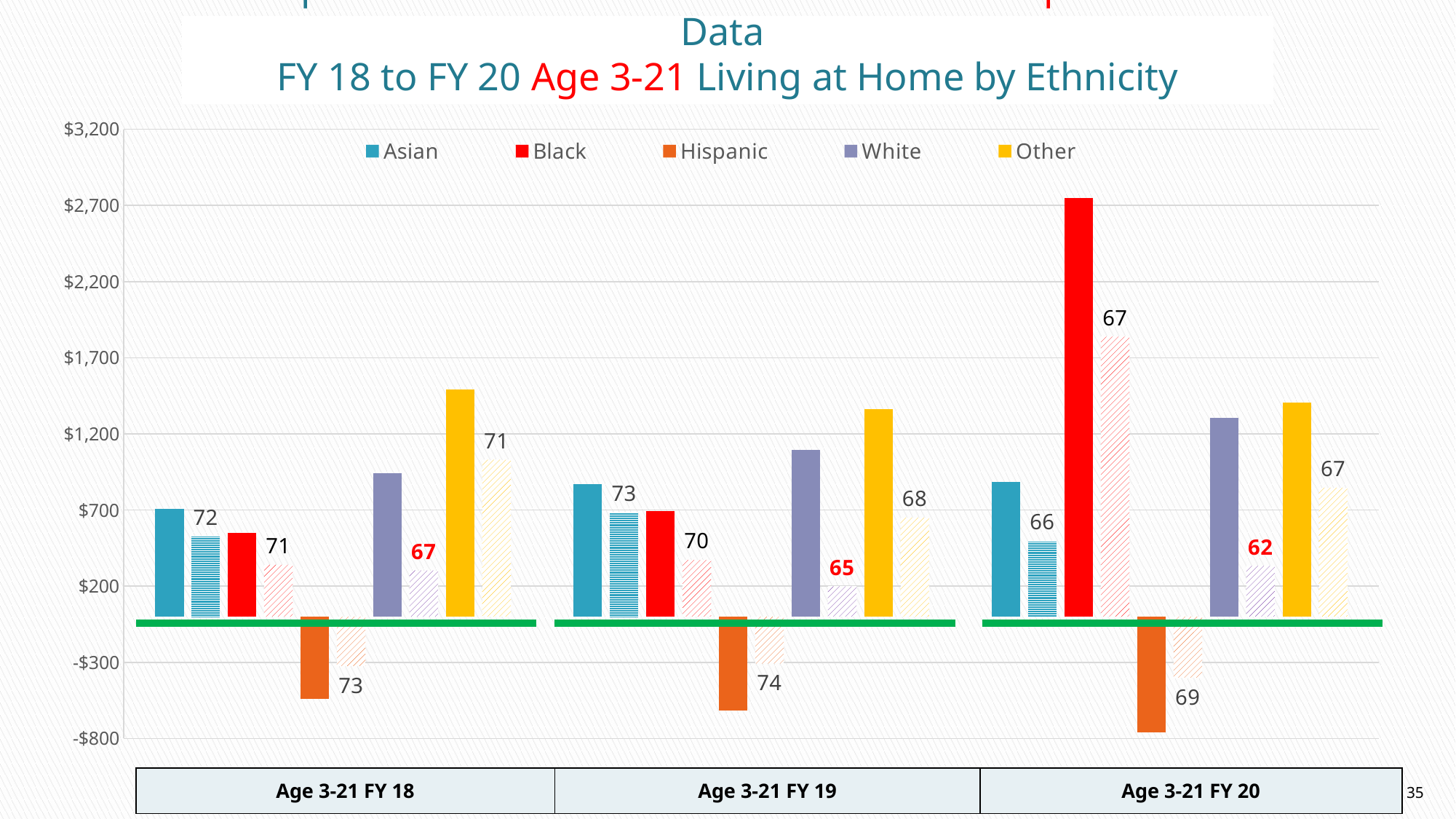
What kind of chart is shown on the slide? bar chart Is the value for Other in Age 3-21 FY 18 greater or less than $1,200? greater Which series has the tallest bar in the Age 3-21 FY 20 group? Black Do the Hispanic bars rise or fall from Age 3-21 FY 18 to Age 3-21 FY 20? fall Which series has the lowest bar in the Age 3-21 FY 20 group? Hispanic Is the value for Black in Age 3-21 FY 20 greater or less than $2,200? greater How many fiscal-year groups are shown along the x axis? 3 In the Age 3-21 FY 18 group, which is larger, the Other bar or the White bar? Other How many series does the legend list? 5 Is the value for Hispanic in Age 3-21 FY 20 greater or less than -$300? less What data label is printed next to the Hispanic bar in the Age 3-21 FY 19 group? 74 What colour represents the Black series in the legend? red